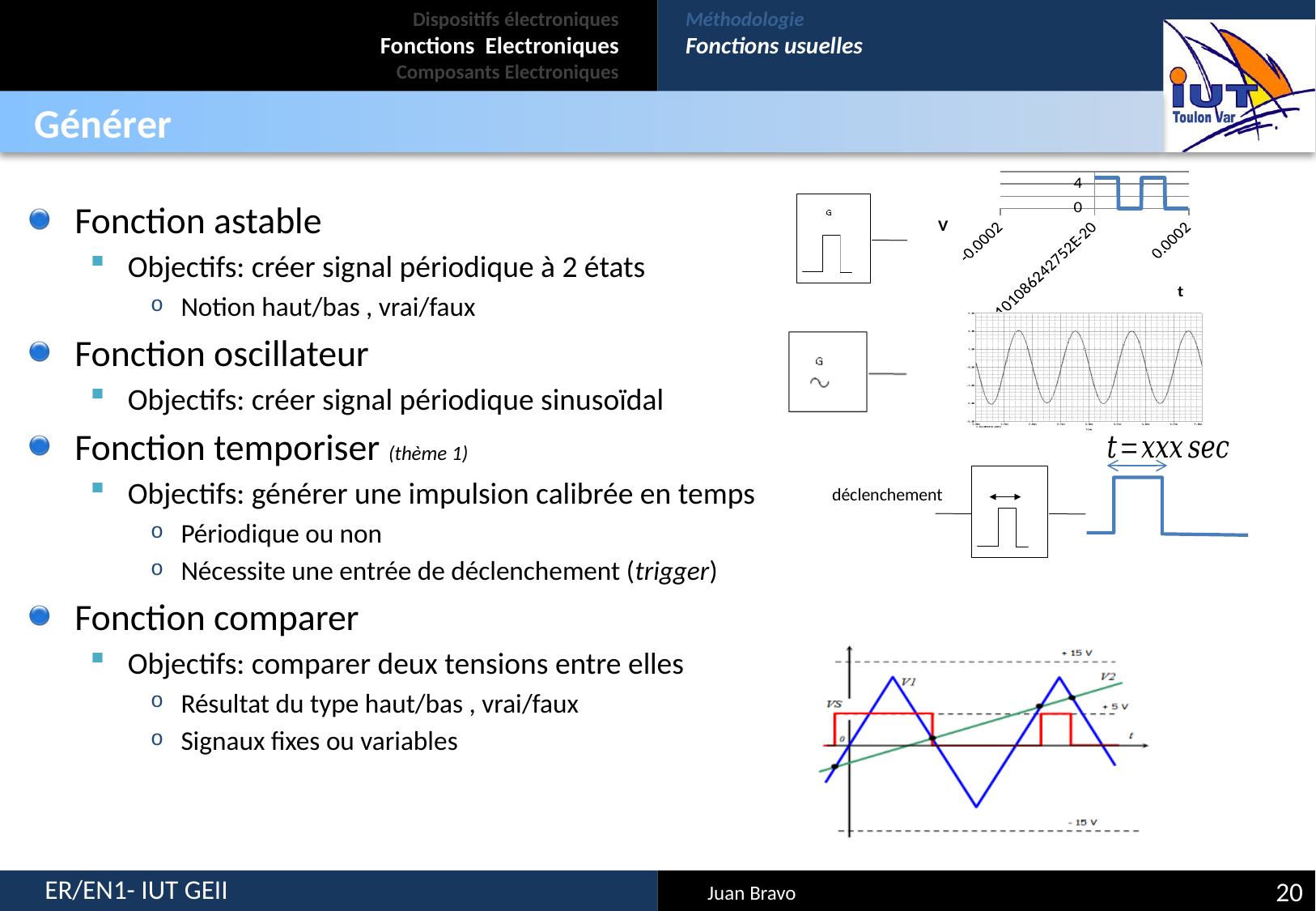
In the top-right chart (axes V and t), what is the low level of the square wave as read from the y-axis? 0 In the comparator diagram at the bottom right of the slide, what voltage is marked on the upper dashed line? + 15 V In the top-right chart, what is the rightmost tick value printed on the horizontal axis? 0.0002 What label is shown on the vertical axis of the top-right chart? V In the top-right chart, what is the leftmost tick value printed on the horizontal axis? -0.0002 In the comparator diagram at the bottom right of the slide, what voltage is marked on the lower dashed line? - 15 V In the comparator diagram at the bottom right of the slide, what voltage is marked on the dashed line just above the red signal? + 5 V What label is shown on the horizontal axis of the top-right chart? t How many tick labels are printed on the vertical axis of the top-right chart? 2 What kind of chart is the chart in the top-right corner of the slide (with axes labelled V and t)? line chart